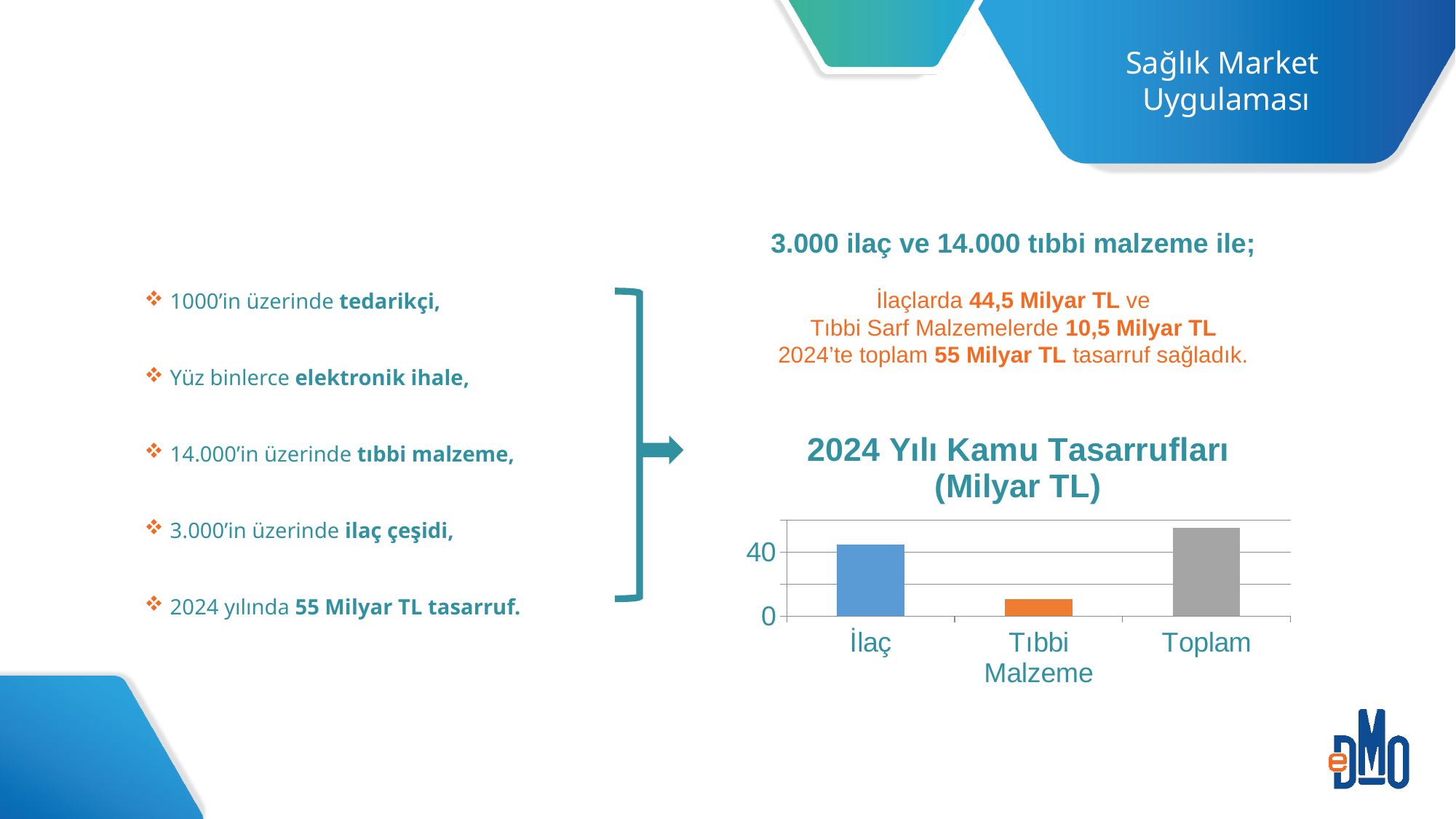
In the "2024 Yılı Kamu Tasarrufları" chart, which is larger: Toplam or İlaç? Toplam What colour is the Tıbbi Malzeme bar in the "2024 Yılı Kamu Tasarrufları" chart? orange How many categories are shown on the x axis of the "2024 Yılı Kamu Tasarrufları" chart? 3 What unit is given in the title of the bar chart on the slide? Milyar TL Which category has the lowest bar in the "2024 Yılı Kamu Tasarrufları" chart? Tıbbi Malzeme In the "2024 Yılı Kamu Tasarrufları" chart, is the value for İlaç greater or less than 40? greater Which category has the highest bar in the "2024 Yılı Kamu Tasarrufları" chart? Toplam In the "2024 Yılı Kamu Tasarrufları" chart, which is larger: İlaç or Tıbbi Malzeme? İlaç In the "2024 Yılı Kamu Tasarrufları" chart, is the value for Tıbbi Malzeme greater or less than 40? less What type of chart is shown under the title "2024 Yılı Kamu Tasarrufları (Milyar TL)"? bar chart In the "2024 Yılı Kamu Tasarrufları" chart, is the value for Toplam greater or less than 40? greater